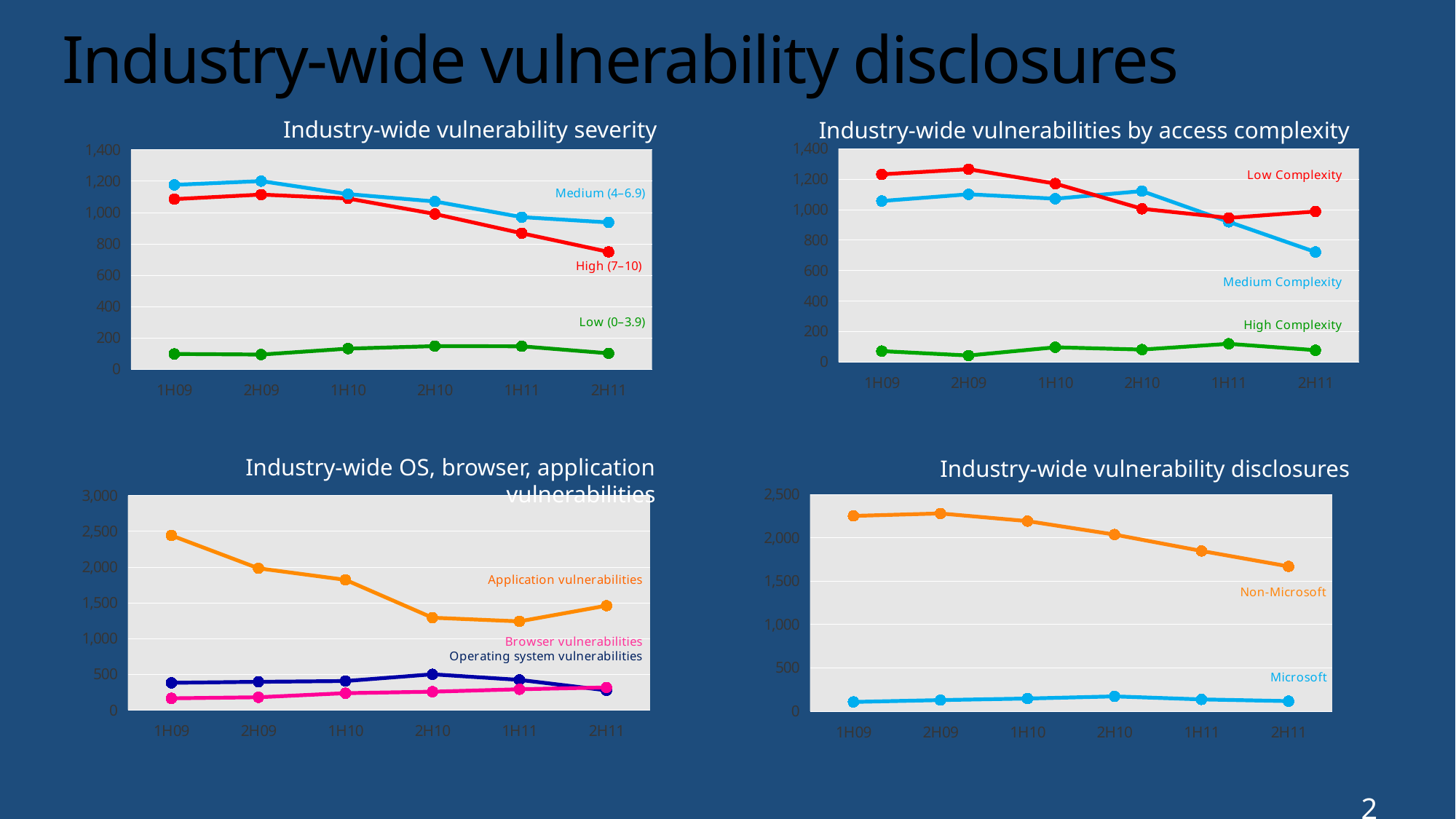
In the "Industry-wide vulnerabilities by access complexity" chart, which is larger at 2H11: Low Complexity or Medium Complexity? Low Complexity In the "Industry-wide vulnerability disclosures" chart, is the value for Microsoft at 2H10 greater or less than 500? less In the "Industry-wide vulnerability severity" chart, how many series are plotted? 3 In the "Industry-wide OS, browser, application vulnerabilities" chart, how many series are plotted? 3 In the "Industry-wide vulnerabilities by access complexity" chart, which series has the lowest value at 1H09? High Complexity In the "Industry-wide vulnerability disclosures" chart, does the Non-Microsoft line rise or fall from 2H09 to 2H11? fall In the "Industry-wide OS, browser, application vulnerabilities" chart, is the value for Application vulnerabilities at 1H09 greater or less than 2,000? greater What kind of chart is the "Industry-wide vulnerability severity" chart? Line chart In the "Industry-wide vulnerability severity" chart, is the value for Low (0–3.9) at 2H11 greater or less than 200? less In the "Industry-wide vulnerability severity" chart, does the High (7–10) line rise or fall from 2H09 to 2H11? fall In the "Industry-wide vulnerability severity" chart, how many periods are shown on the x axis? 6